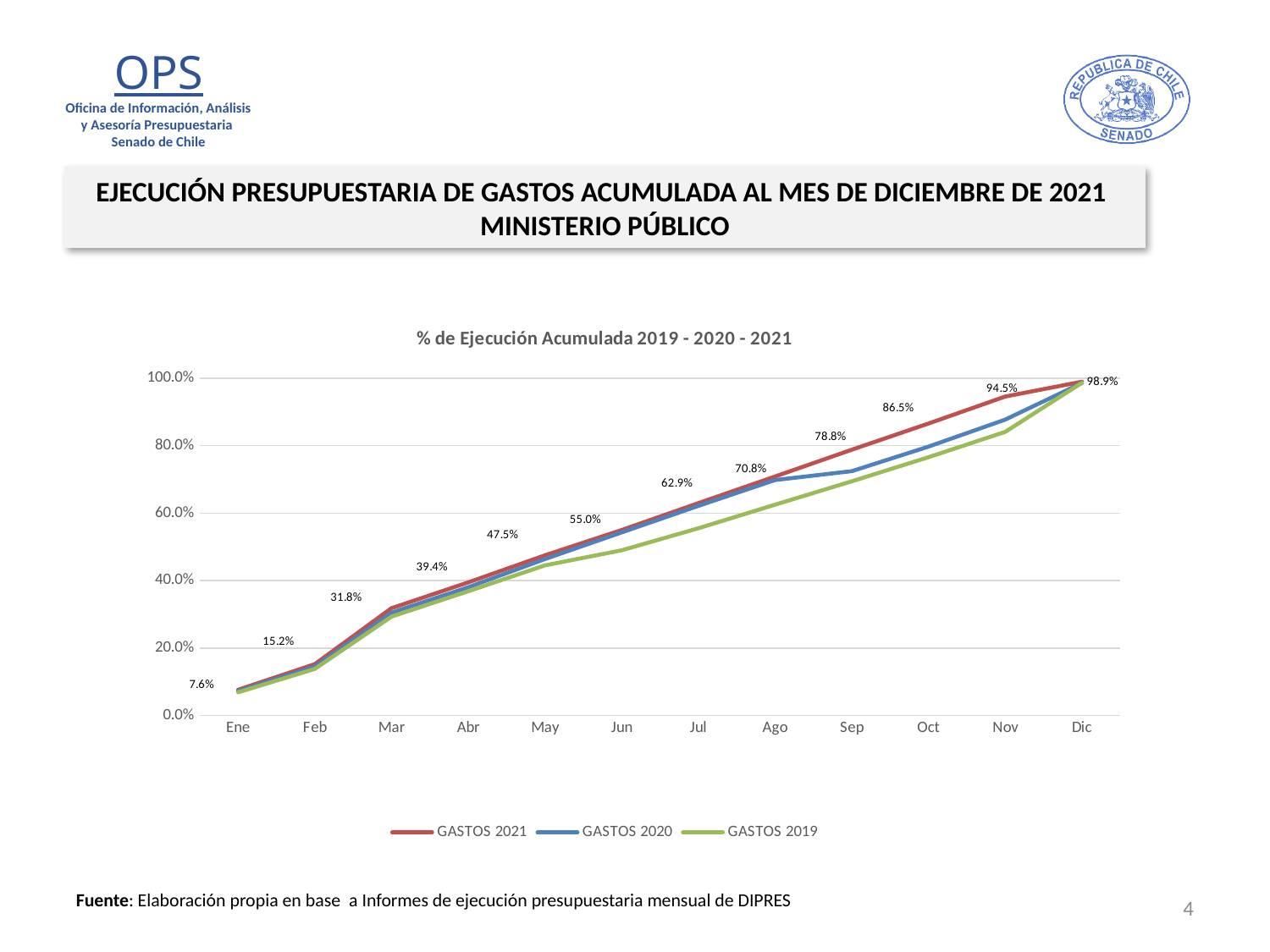
What is the value for GASTOS 2021 in Ene? 7.6% What is the difference between the GASTOS 2021 values for Dic and Nov? 4.4 percentage points What kind of chart is shown on the slide? Line chart How many series does the legend list? 3 What is the difference between the GASTOS 2021 values for Feb and Ene? 7.6 percentage points In Oct, which series is higher, GASTOS 2021 or GASTOS 2019? GASTOS 2021 Do the GASTOS 2021 values rise or fall from Ene to Dic? Rise What is the value for GASTOS 2021 in Dic? 98.9% Is the value for GASTOS 2019 in Sep greater or less than 80.0%? less What is the value for GASTOS 2021 in Jun? 55.0% What is the title of the chart? % de Ejecución Acumulada 2019 - 2020 - 2021 How many months are plotted along the x axis? 12